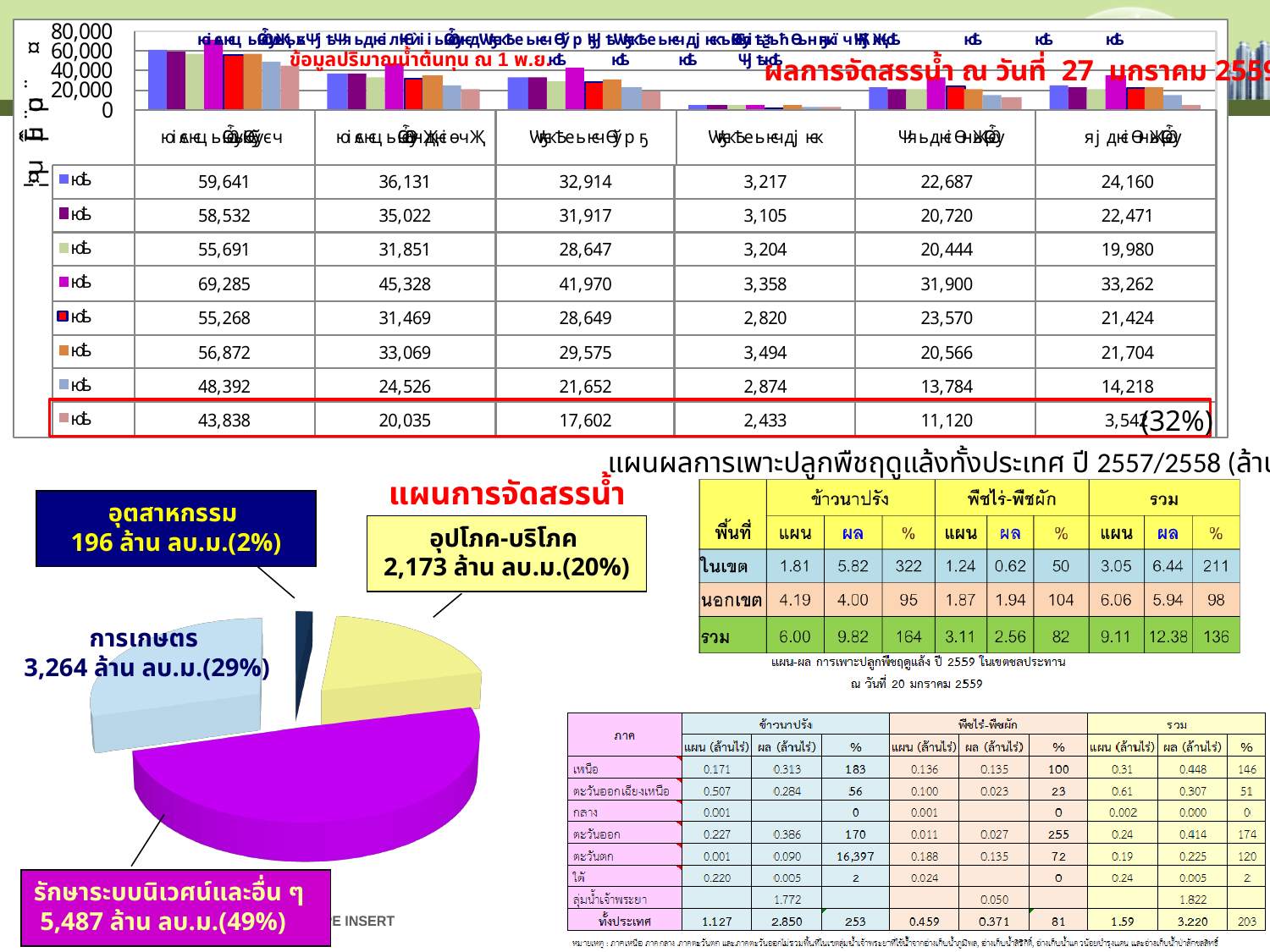
In the pie chart แผนการจัดสรรน้ำ, what is the value for การเกษตร? 3,264 ล้าน ลบ.ม. In the pie chart แผนการจัดสรรน้ำ, which is larger, อุปโภค-บริโภค or การเกษตร? การเกษตร In the pie chart แผนการจัดสรรน้ำ, what share of the pie does อุตสาหกรรม represent? 2% In the pie chart แผนการจัดสรรน้ำ, which category has the largest slice? รักษาระบบนิเวศน์และอื่น ๆ In the pie chart แผนการจัดสรรน้ำ, what is the value for อุปโภค-บริโภค? 2,173 ล้าน ลบ.ม. What kind of chart is the chart at the top of the slide? bar chart How many series does the legend of the bar chart at the top of the slide list? 8 In the pie chart แผนการจัดสรรน้ำ, which category has the smallest slice? อุตสาหกรรม In the pie chart แผนการจัดสรรน้ำ, what is the difference between the values for รักษาระบบนิเวศน์และอื่น ๆ and การเกษตร? 2,223 ล้าน ลบ.ม. What kind of chart is the chart at the bottom left of the slide titled แผนการจัดสรรน้ำ? pie chart In the pie chart แผนการจัดสรรน้ำ, what share of the pie does รักษาระบบนิเวศน์และอื่น ๆ represent? 49% How many slices does the pie chart แผนการจัดสรรน้ำ have? 4